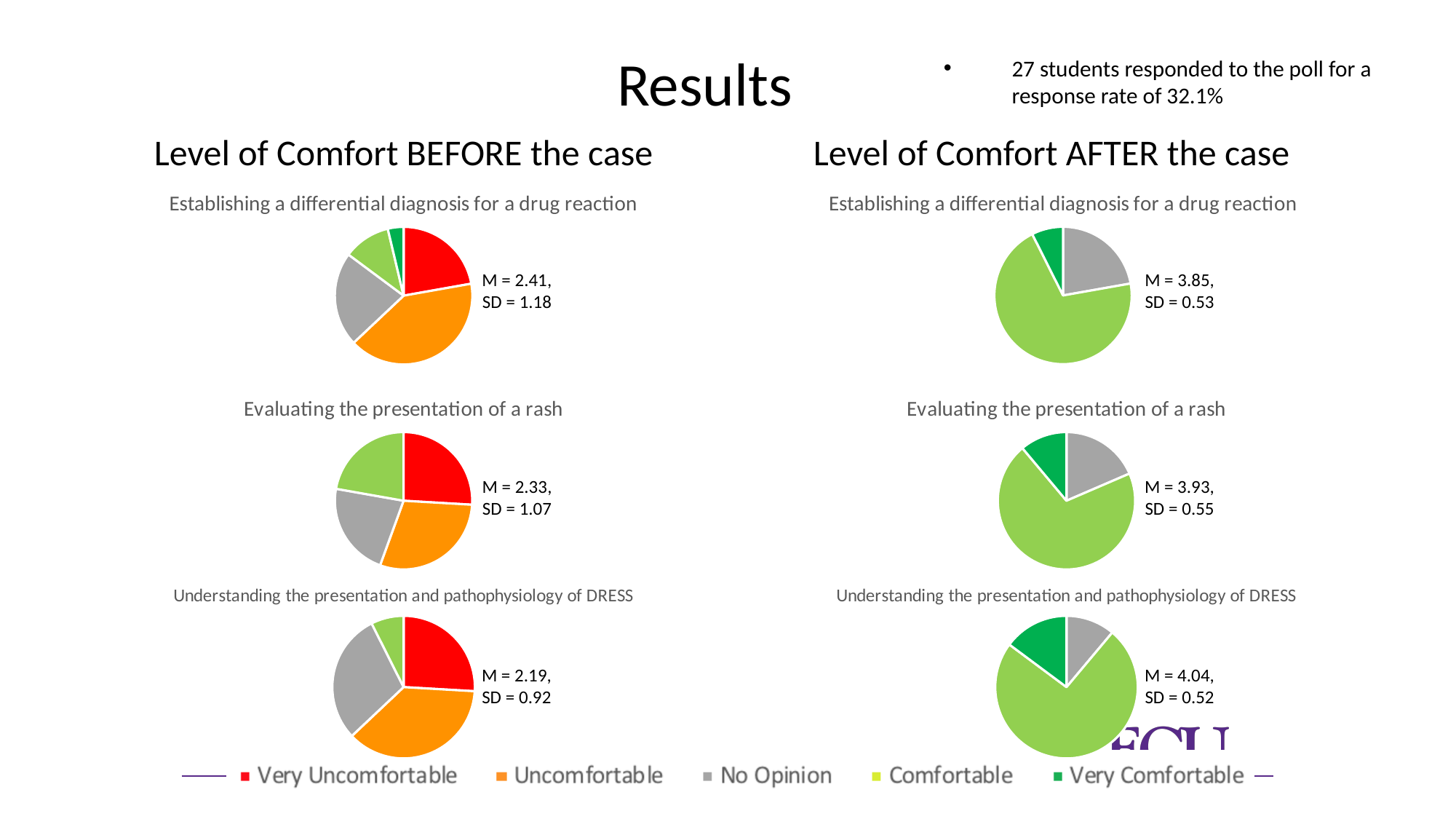
In the BEFORE chart for 'Evaluating the presentation of a rash', what is the SD? 1.07 In the AFTER chart for 'Establishing a differential diagnosis for a drug reaction', what is the SD? 0.53 In the BEFORE chart for 'Establishing a differential diagnosis for a drug reaction', what is the mean (M)? 2.41 In the BEFORE chart for 'Establishing a differential diagnosis for a drug reaction', which response category has the largest slice? Uncomfortable In the AFTER chart for 'Evaluating the presentation of a rash', which response category has the largest slice? Comfortable In the AFTER chart for 'Understanding the presentation and pathophysiology of DRESS', what is the mean (M)? 4.04 In the BEFORE chart for 'Establishing a differential diagnosis for a drug reaction', which response category has the smallest slice? Very Comfortable How many entries does the legend at the bottom of the slide list? 5 What is the difference between the AFTER and BEFORE means for 'Establishing a differential diagnosis for a drug reaction'? 1.44 What kind of charts are shown on the slide? Pie charts How many pie charts are on the slide? 6 Which is larger: the mean for 'Evaluating the presentation of a rash' BEFORE the case or AFTER the case? AFTER the case